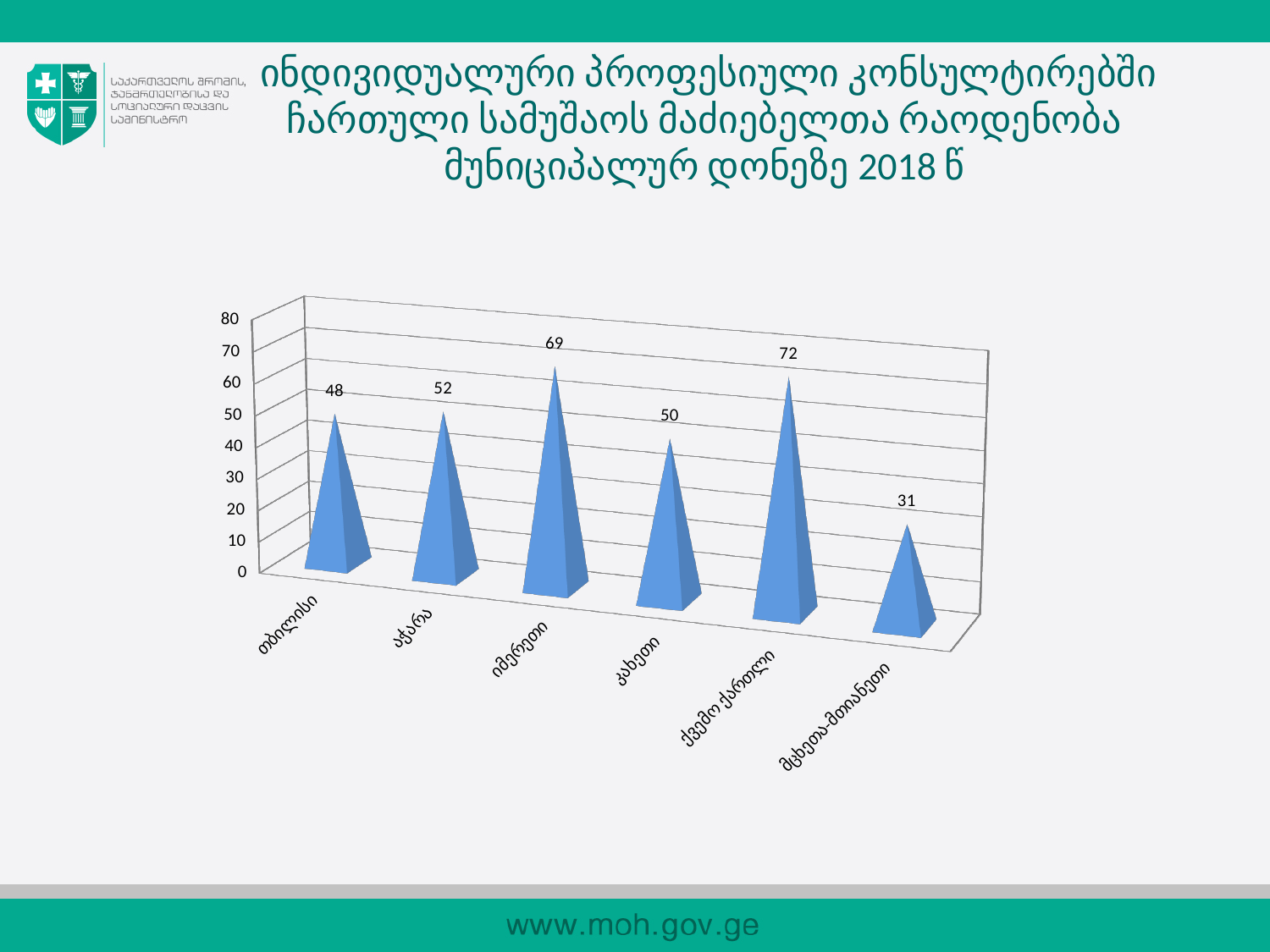
Which is larger, the value for აჭარა or the value for თბილისი? აჭარა What is the difference between the values for იმერეთი and აჭარა? 17 What is the value for მცხეთა-მთიანეთი? 31 What is the value for იმერეთი? 69 What is the difference between the values for ქვემო ქართლი and მცხეთა-მთიანეთი? 41 Which category has the highest value? ქვემო ქართლი Which category has the lowest value? მცხეთა-მთიანეთი How many categories are shown on the x axis? 6 Is the value for ქვემო ქართლი greater or less than 60? greater What kind of chart is shown on the slide? bar chart What is the value for თბილისი? 48 What is the value for კახეთი? 50